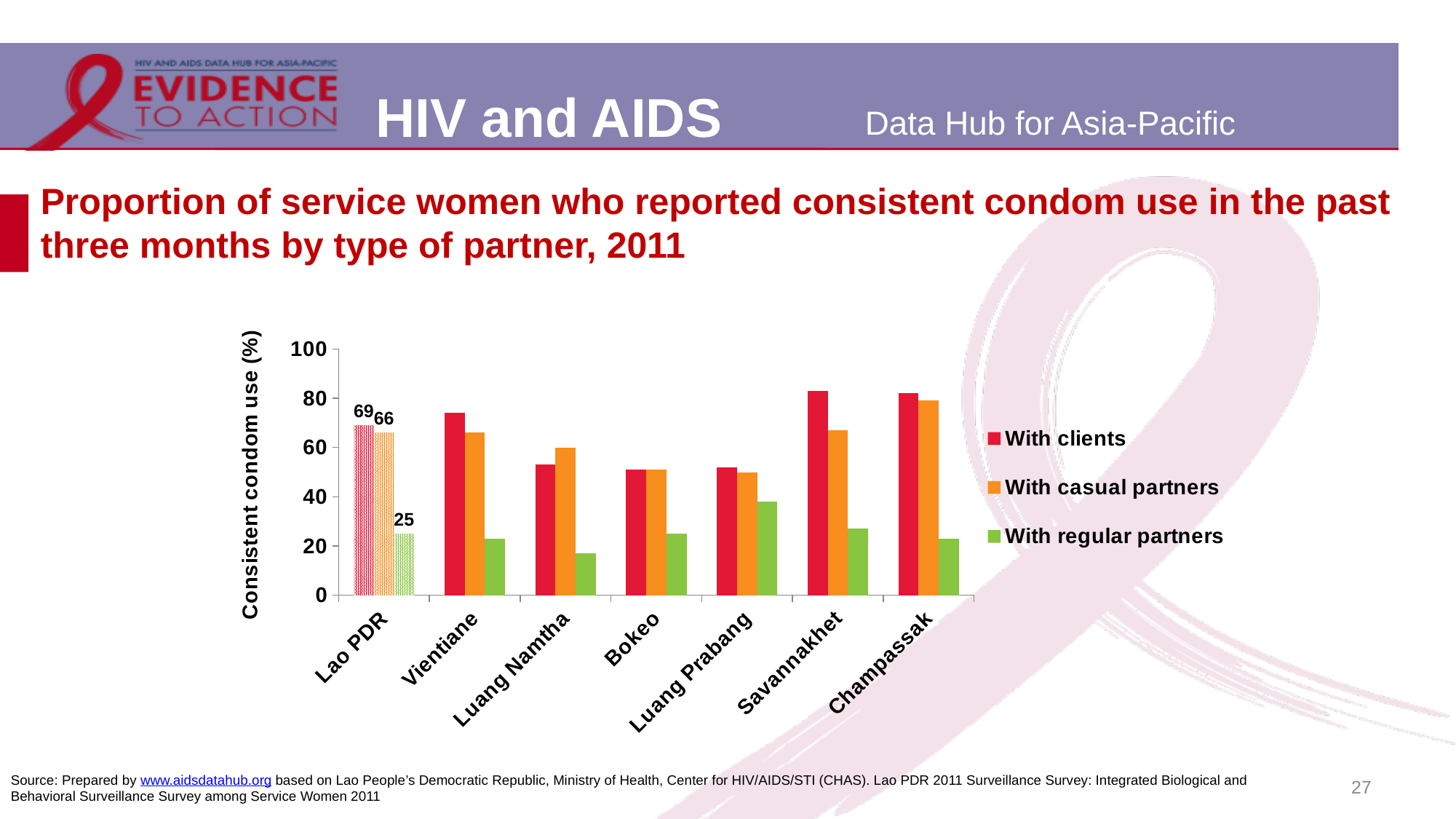
What is the value for Lao PDR in the 'With clients' series? 69 Which location has the highest 'With regular partners' value? Luang Prabang What is the value for Lao PDR in the 'With regular partners' series? 25 For Lao PDR, which is larger: the 'With clients' value or the 'With casual partners' value? With clients Is the 'With regular partners' value for Luang Namtha greater or less than 20? less What is the value for Lao PDR in the 'With casual partners' series? 66 How many series does the legend list? 3 What kind of chart is shown on the slide? Bar chart Which location has the lowest 'With regular partners' value? Luang Namtha How many locations are shown on the x axis? 7 Is the 'With clients' value for Savannakhet greater or less than 80? greater For Lao PDR, what is the difference between the 'With clients' value and the 'With regular partners' value? 44